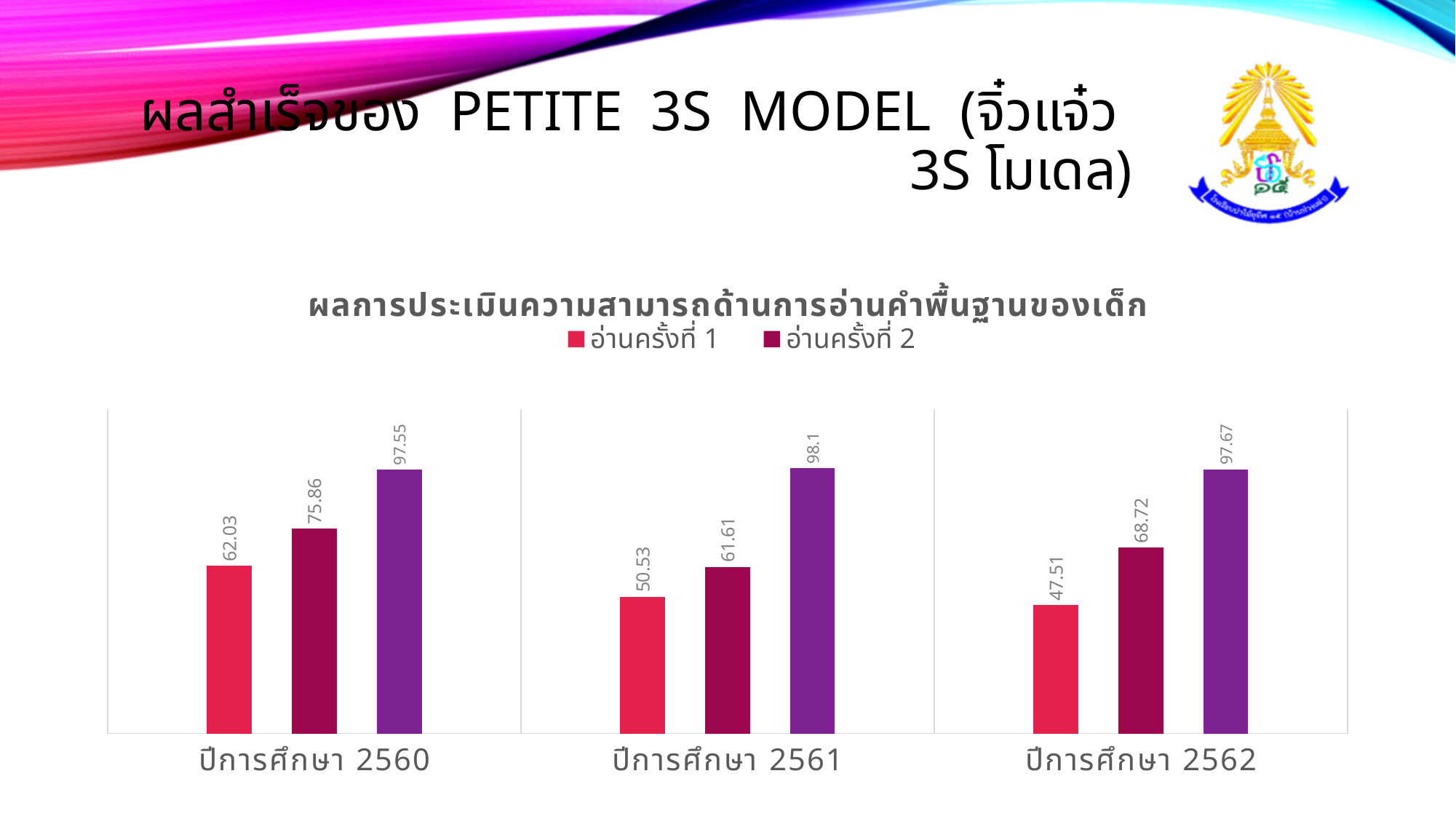
Which is larger: อ่านครั้งที่ 1 for ปีการศึกษา 2561 or อ่านครั้งที่ 1 for ปีการศึกษา 2562? ปีการศึกษา 2561 Which academic year has the lowest value for อ่านครั้งที่ 2? ปีการศึกษา 2561 What kind of chart is shown on the slide? Bar chart What is the value of อ่านครั้งที่ 1 for ปีการศึกษา 2560? 62.03 How many series does the legend list? 2 What is the value of the purple (third) bar for ปีการศึกษา 2561? 98.1 What is the difference between อ่านครั้งที่ 2 and อ่านครั้งที่ 1 for ปีการศึกษา 2562? 21.21 How many academic years (categories) are shown on the x axis? 3 What is the difference between อ่านครั้งที่ 2 and อ่านครั้งที่ 1 for ปีการศึกษา 2560? 13.83 What is the value of อ่านครั้งที่ 2 for ปีการศึกษา 2561? 61.61 Which academic year has the highest value for อ่านครั้งที่ 1? ปีการศึกษา 2560 What is the value of อ่านครั้งที่ 1 for ปีการศึกษา 2562? 47.51